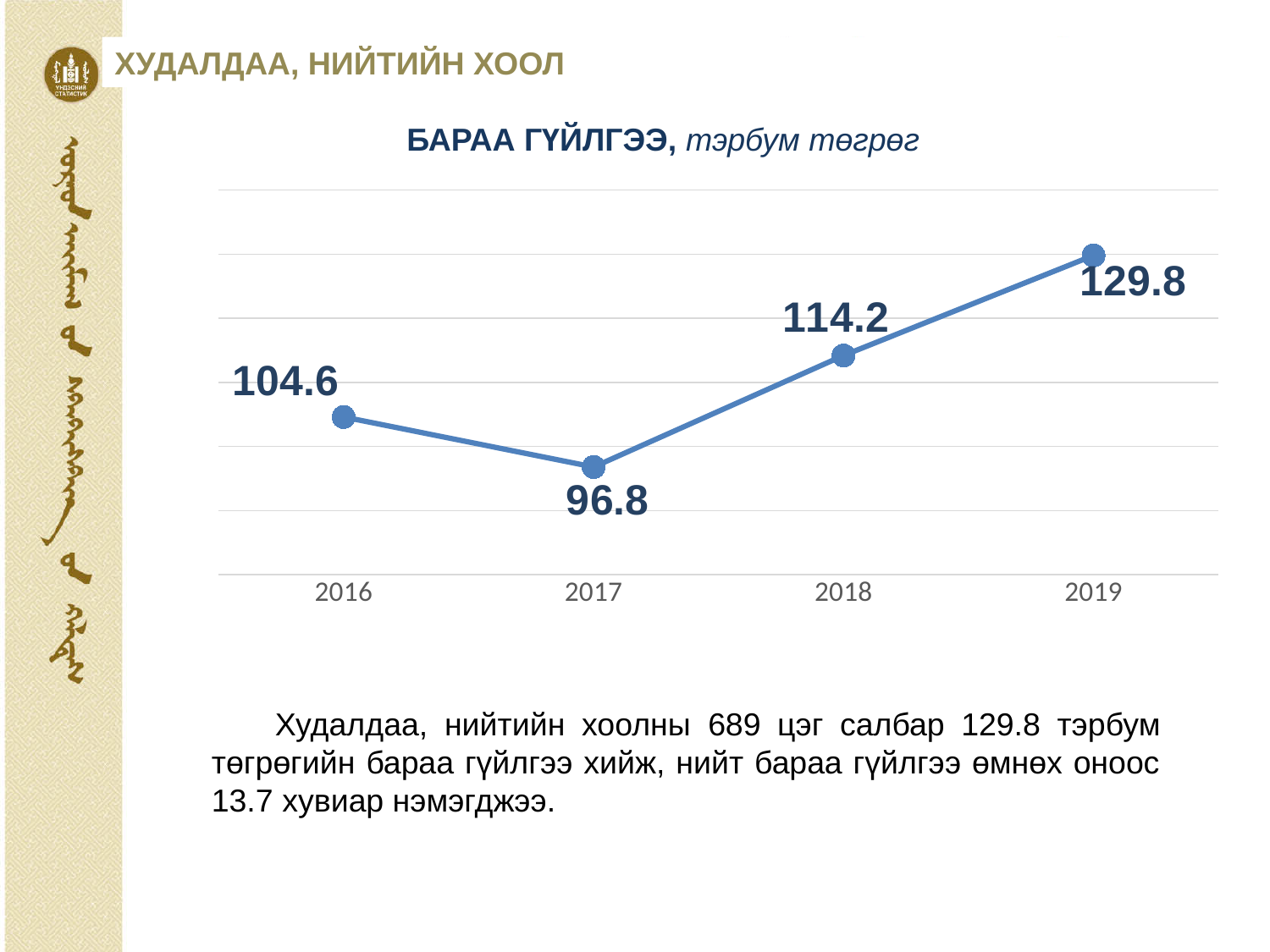
What is the value for 2016? 104.6 What is the difference between the values for 2016 and 2017? 7.8 What is the value for 2018? 114.2 What kind of chart is shown? line chart What is the value for 2017? 96.8 How many years are plotted on the chart? 4 What is the difference between the values for 2019 and 2018? 15.6 Which year has the highest value? 2019 Which year has the lowest value? 2017 Which is larger, the value for 2016 or the value for 2018? 2018 What is the title of the chart? БАРАА ГҮЙЛГЭЭ, тэрбум төгрөг What is the value for 2019? 129.8